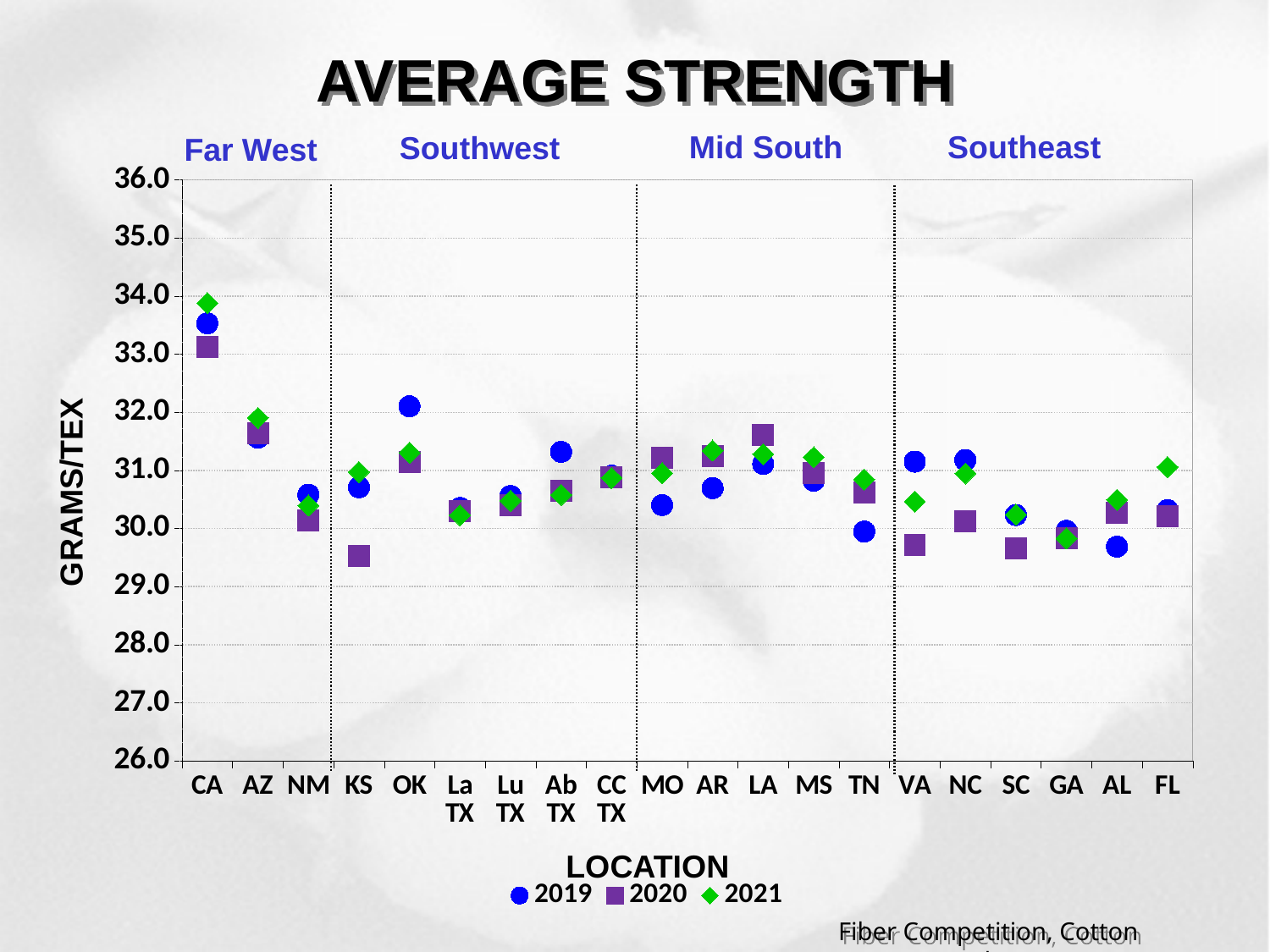
Is the 2019 value for OK greater or less than 31.0? greater Is the 2020 value for VA greater or less than 30.0? less How many locations are plotted along the x axis? 20 What is the title of the y axis? GRAMS/TEX Is the 2021 value for CA greater or less than 33.0? greater How many series does the legend list? 3 What kind of chart is shown on the slide? scatter chart Which is larger, the 2019 value for CA or the 2019 value for AZ? CA Which location has the highest 2021 average strength? CA Which is larger for KS, the 2020 value or the 2021 value? 2021 Which location has the highest 2019 average strength? CA